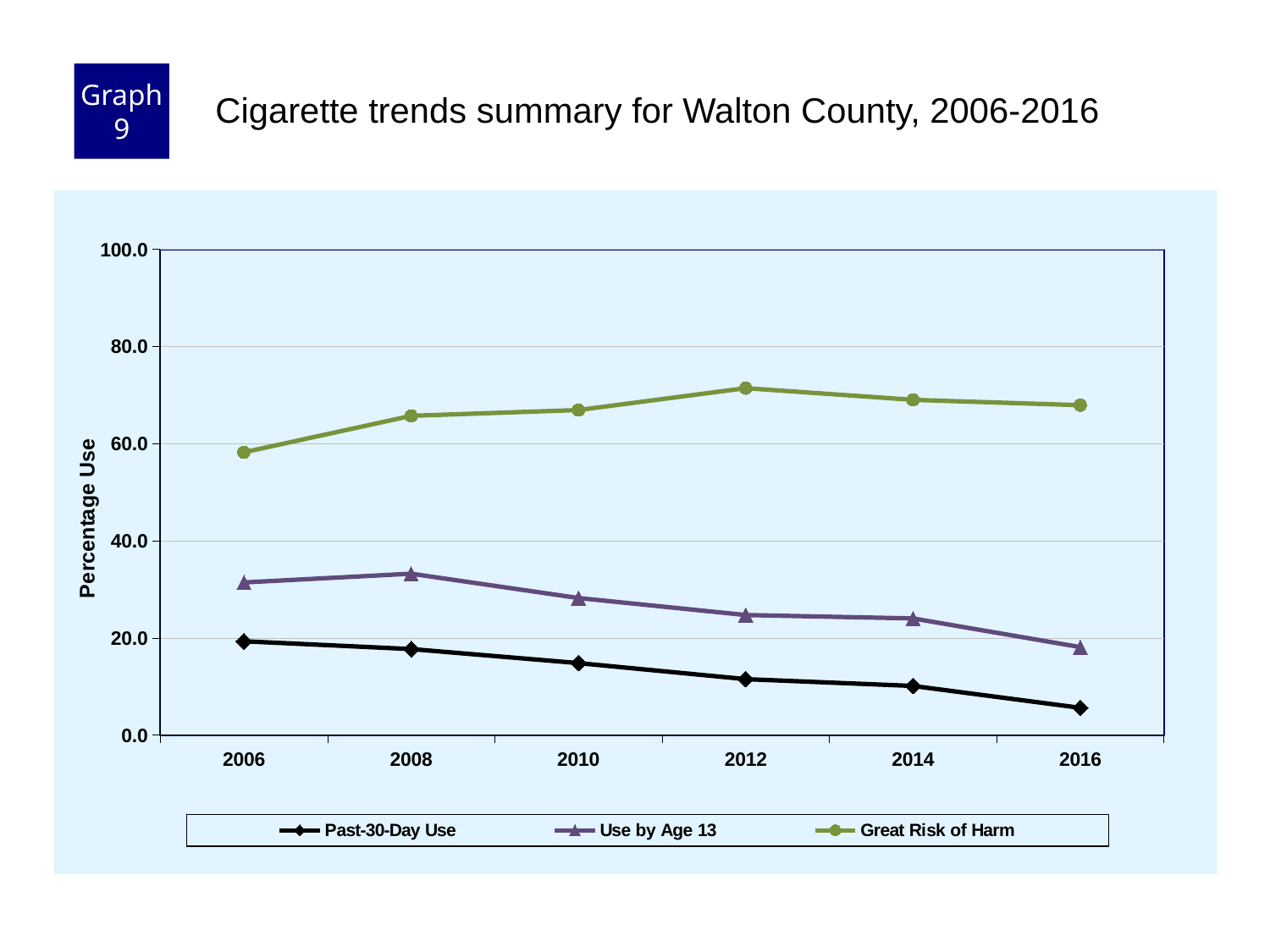
How many series does the legend list? 3 Does the Past-30-Day Use series rise or fall from 2006 to 2016? Fall Is the value for Great Risk of Harm in 2006 greater or less than 60.0? less In which year is Use by Age 13 at its lowest? 2016 Is the value for Past-30-Day Use in 2016 greater or less than 10.0? less In 2006, which is larger: Use by Age 13 or Past-30-Day Use? Use by Age 13 Is the value for Great Risk of Harm in 2012 greater or less than 60.0? greater How many years are plotted along the x axis? 6 In which year is Great Risk of Harm at its highest? 2012 What kind of chart is shown on the slide? Line chart What is the label on the y axis? Percentage Use In which year is Past-30-Day Use at its lowest? 2016